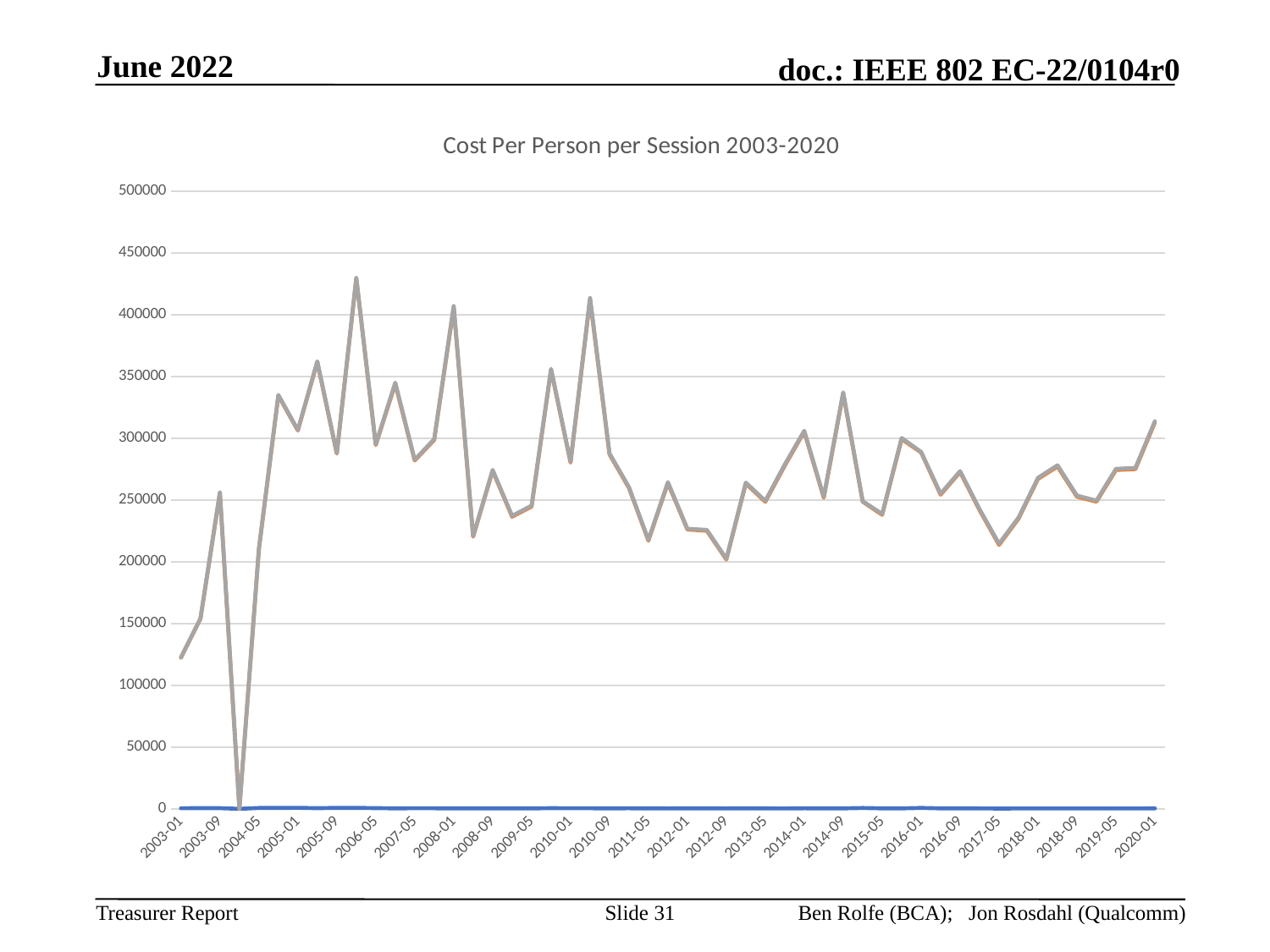
Is the value for 2018-09 greater or less than 300000? less Is the value for 2013-05 greater or less than 300000? less Is the value for 2005-01 greater or less than 250000? greater Does the value rise or fall from 2018-09 to 2020-01? rise What kind of chart is shown on the slide? line chart What is the highest value shown on the vertical axis? 500000 What is the title of the chart? Cost Per Person per Session 2003-2020